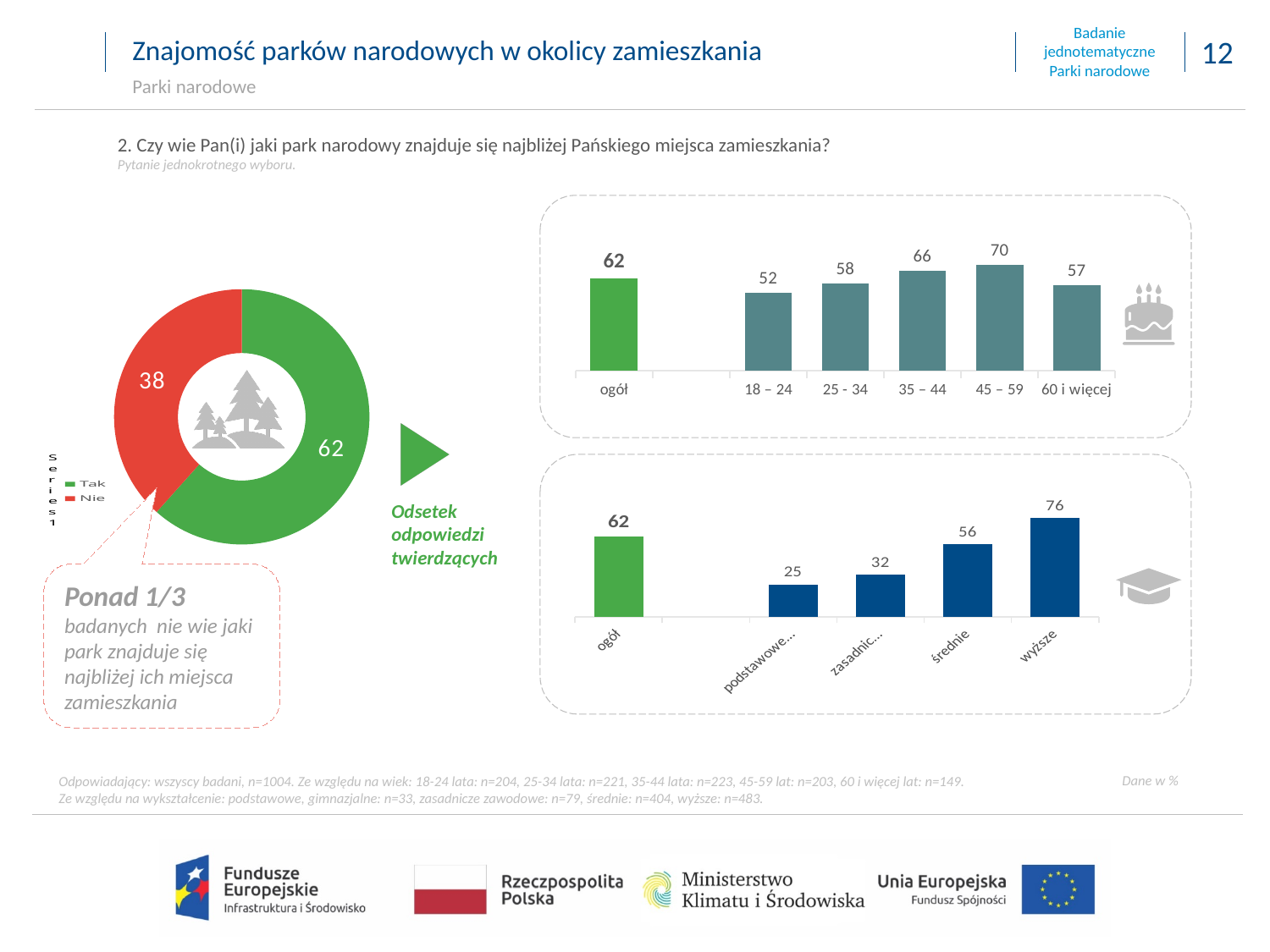
In the donut chart on the left, what is the value for "Nie"? 38 In the bottom-right bar chart (by education), what is the difference between the values for "wyższe" and "średnie"? 20 In the top-right bar chart (by age), what is the value for the 45 – 59 age group? 70 In the bottom-right bar chart (by education), which category has the lowest value? podstawowe In the bottom-right bar chart (by education), what is the value for "wyższe"? 76 In the top-right bar chart (by age), which age group has the lowest value? 18 – 24 In the top-right bar chart (by age), which age group has the highest value? 45 – 59 In the bottom-right bar chart (by education), which is larger: the value for "średnie" or the value for "ogół"? ogół What kind of chart is the chart on the left of the slide? Pie (donut) chart In the donut chart on the left, what is the value for "Tak"? 62 In the top-right bar chart (by age), how many bars are plotted? 6 In the top-right bar chart (by age), what is the difference between the values for 35 – 44 and 18 – 24? 14